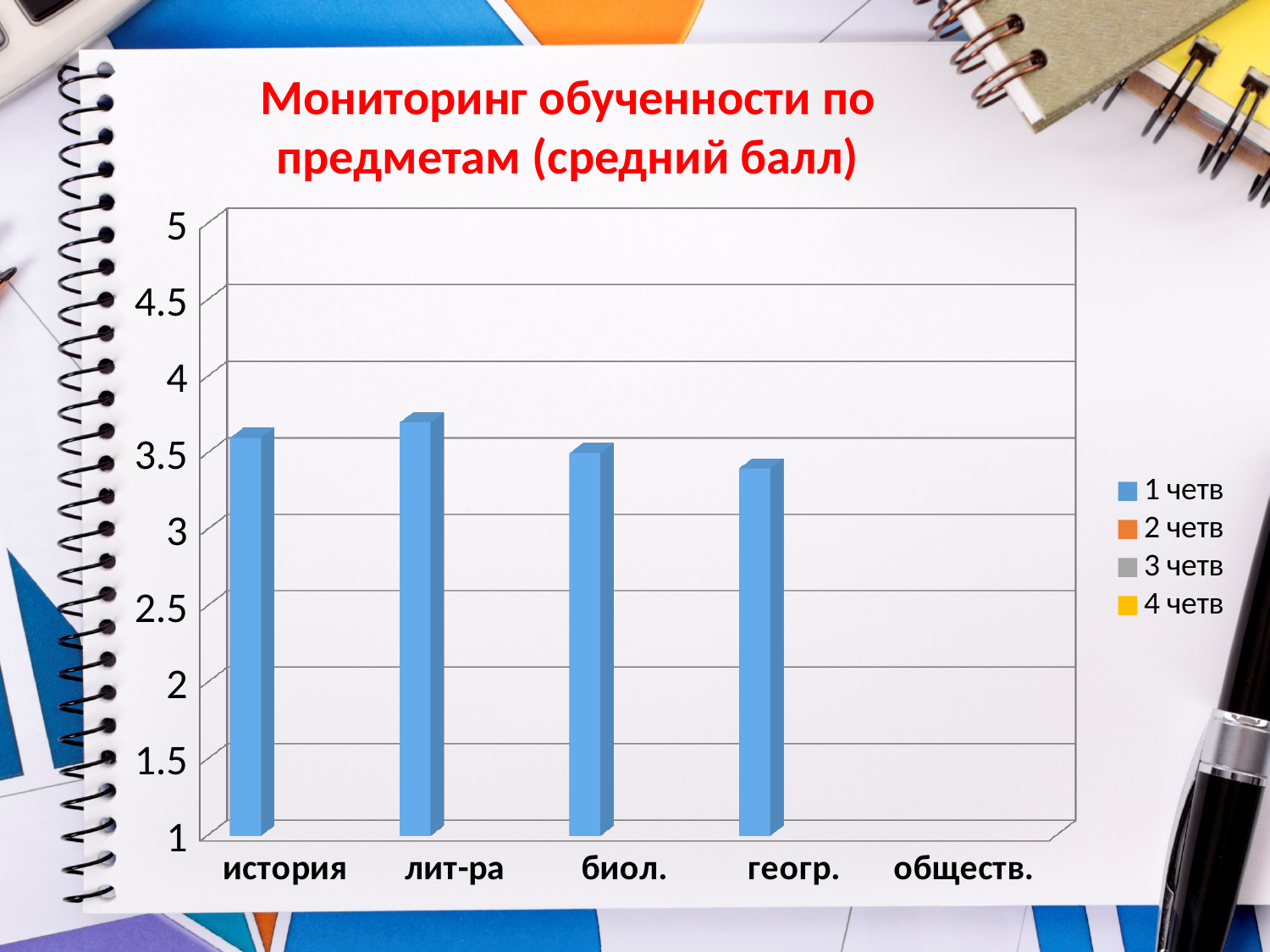
How many series does the chart's legend list? 4 Is the value for биол. greater or less than 4? less Which category on the x axis has no bar plotted? обществ. Is the value for лит-ра greater or less than 3.5? greater Which subject has the highest bar in the chart? лит-ра Is the value for геогр. greater or less than 3? greater Which has the larger value, история or геогр.? история Which has the larger value, лит-ра or биол.? лит-ра What kind of chart is shown on the slide? bar chart Do the bar values rise or fall from лит-ра to геогр.? fall How many categories are shown on the x axis of the chart? 5